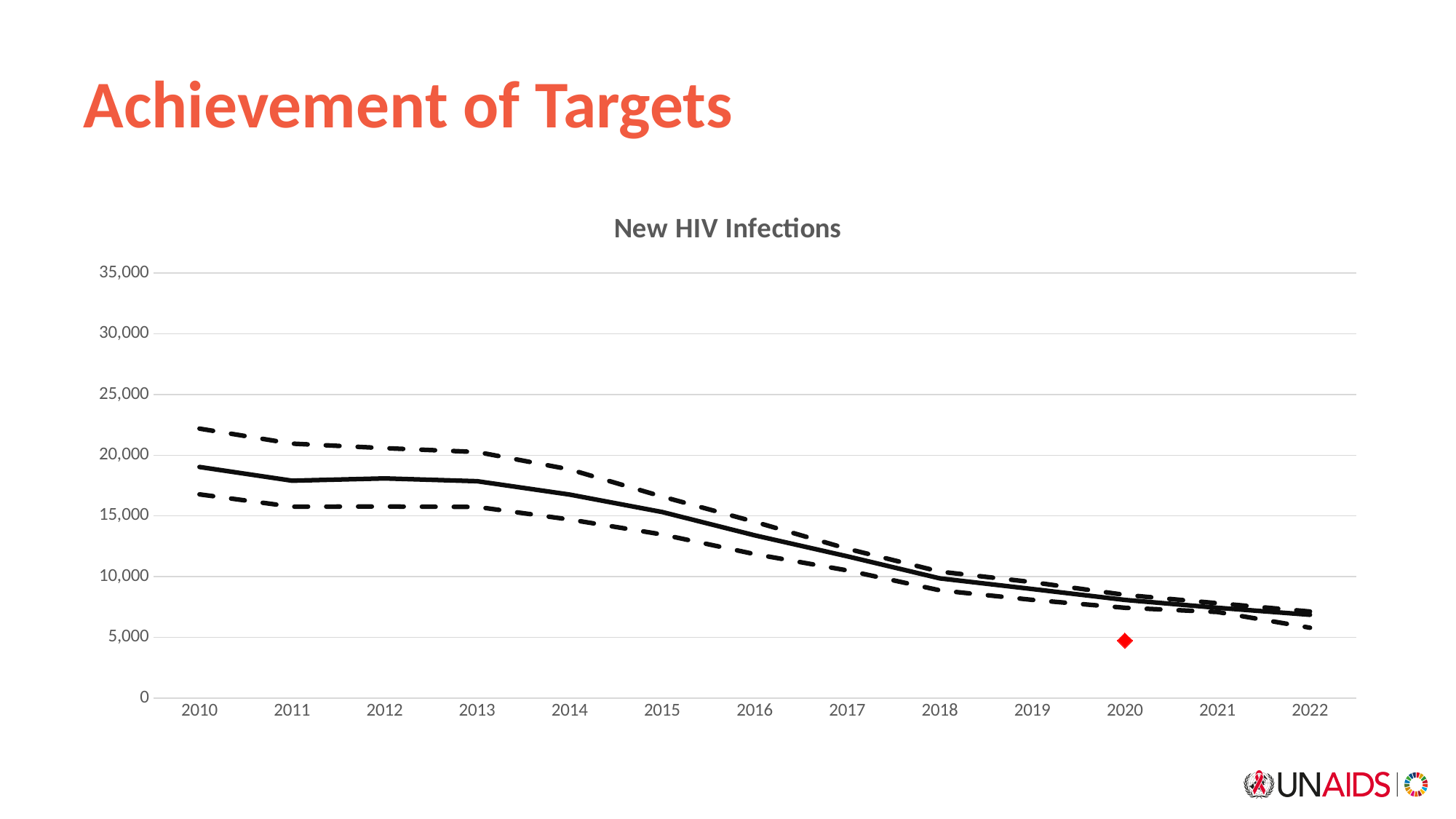
In which year is the solid line for new HIV infections highest? 2010 What is the title of the chart? New HIV Infections Is the red diamond marker at 2020 greater or less than 10,000? less Is the value of the solid line in 2022 greater or less than 10,000? less In which year is the solid line for new HIV infections lowest? 2022 Which year has the larger value on the solid line, 2010 or 2022? 2010 Is the value of the solid line in 2010 greater or less than 15,000? greater How many years are shown on the x axis of the chart? 13 What kind of chart is shown on the slide? Line chart Does the solid line for new HIV infections rise or fall from 2010 to 2022? Fall